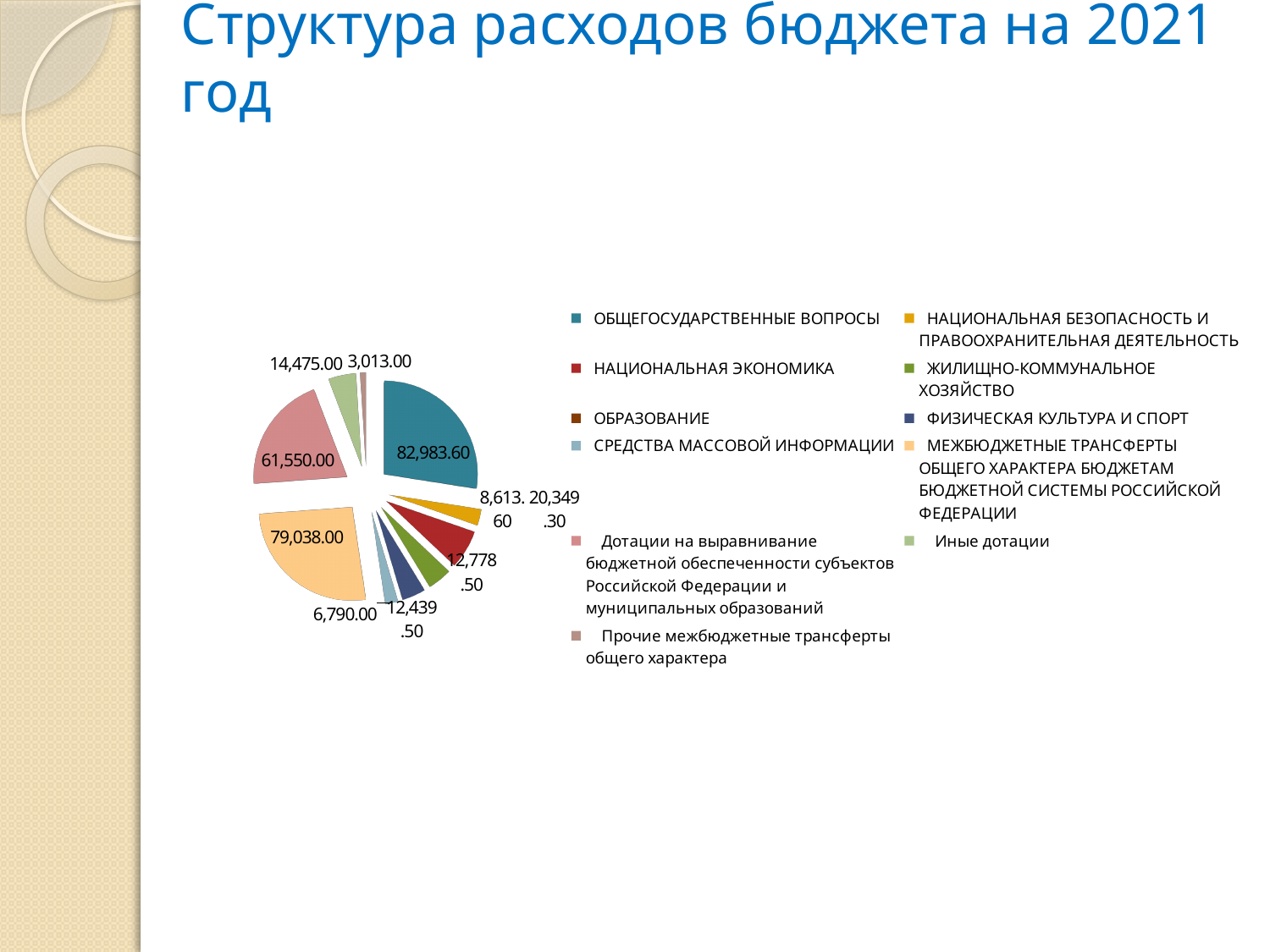
Which category has the largest slice of the pie? ОБЩЕГОСУДАРСТВЕННЫЕ ВОПРОСЫ How many entries does the chart legend list? 11 What is the value shown for Прочие межбюджетные трансферты общего характера? 3,013.00 What is the difference between the value for Дотации на выравнивание бюджетной обеспеченности субъектов Российской Федерации и муниципальных образований and the value for Иные дотации? 47,075.00 What is the value shown for Иные дотации? 14,475.00 What kind of chart is shown on the slide? pie chart What is the difference between the value for ОБЩЕГОСУДАРСТВЕННЫЕ ВОПРОСЫ and the value for МЕЖБЮДЖЕТНЫЕ ТРАНСФЕРТЫ ОБЩЕГО ХАРАКТЕРА БЮДЖЕТАМ БЮДЖЕТНОЙ СИСТЕМЫ РОССИЙСКОЙ ФЕДЕРАЦИИ? 3,945.60 What is the title of the slide containing the chart? Структура расходов бюджета на 2021 год What is the value shown for ОБЩЕГОСУДАРСТВЕННЫЕ ВОПРОСЫ? 82,983.60 What is the value shown for МЕЖБЮДЖЕТНЫЕ ТРАНСФЕРТЫ ОБЩЕГО ХАРАКТЕРА БЮДЖЕТАМ БЮДЖЕТНОЙ СИСТЕМЫ РОССИЙСКОЙ ФЕДЕРАЦИИ? 79,038.00 Which is larger: the value for ОБЩЕГОСУДАРСТВЕННЫЕ ВОПРОСЫ or the value for МЕЖБЮДЖЕТНЫЕ ТРАНСФЕРТЫ ОБЩЕГО ХАРАКТЕРА БЮДЖЕТАМ БЮДЖЕТНОЙ СИСТЕМЫ РОССИЙСКОЙ ФЕДЕРАЦИИ? ОБЩЕГОСУДАРСТВЕННЫЕ ВОПРОСЫ What is the value shown for Дотации на выравнивание бюджетной обеспеченности субъектов Российской Федерации и муниципальных образований? 61,550.00